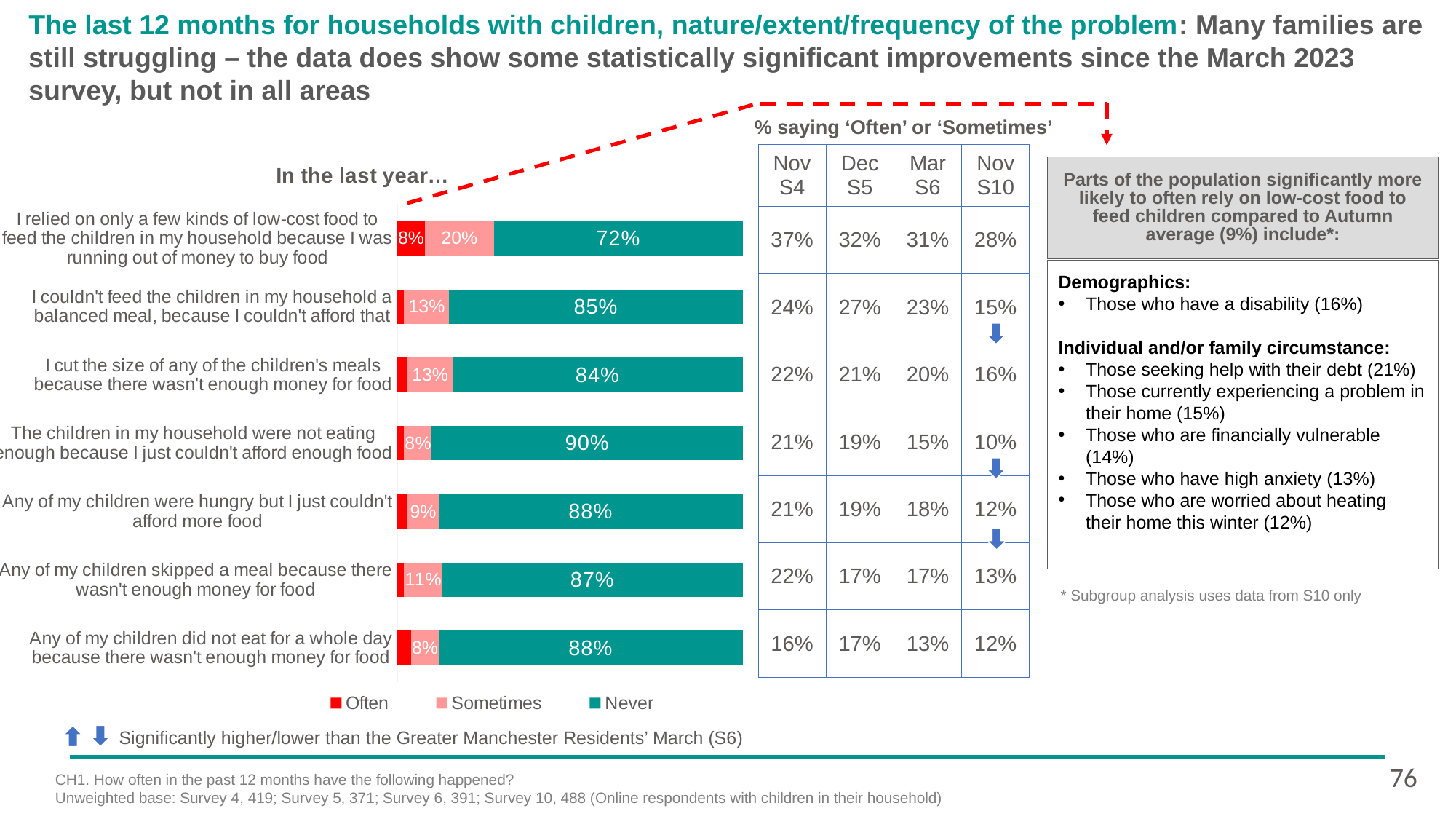
What percentage said 'Never' for 'The children in my household were not eating enough because I just couldn't afford enough food'? 90% What percentage said 'Sometimes' for 'I relied on only a few kinds of low-cost food to feed the children in my household because I was running out of money to buy food'? 20% How many statements (categories) are plotted in the bar chart? 7 What percentage said 'Often' for 'I relied on only a few kinds of low-cost food to feed the children in my household because I was running out of money to buy food'? 8% What percentage said 'Sometimes' for 'Any of my children skipped a meal because there wasn't enough money for food'? 11% How many series does the chart legend list? 3 What is the difference between the 'Never' percentage for 'I couldn't feed the children in my household a balanced meal, because I couldn't afford that' and for 'I cut the size of any of the children's meals because there wasn't enough money for food'? 1% Which series in the legend is shown in red? Often Which statement has the highest 'Never' percentage? The children in my household were not eating enough because I just couldn't afford enough food What kind of chart is shown on the slide? Stacked bar chart Which statement has the lowest 'Never' percentage? I relied on only a few kinds of low-cost food to feed the children in my household because I was running out of money to buy food What percentage said 'Never' for 'I relied on only a few kinds of low-cost food to feed the children in my household because I was running out of money to buy food'? 72%